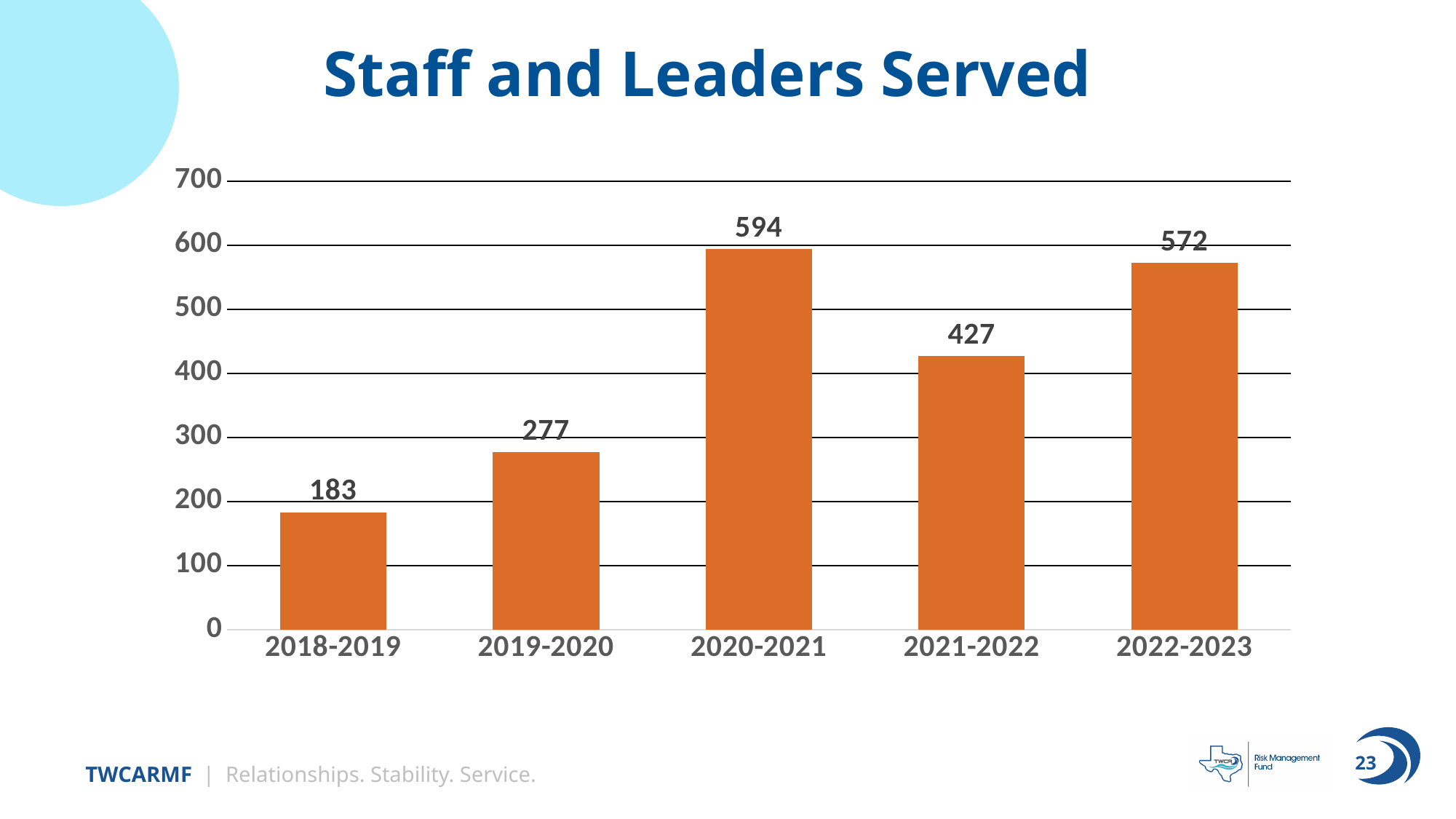
What is the value for 2022-2023? 572 What is the difference between the values for 2020-2021 and 2021-2022? 167 Is the value for 2021-2022 greater or less than 400? greater What is the value for 2020-2021? 594 What is the difference between the values for 2019-2020 and 2018-2019? 94 Which year has the highest value? 2020-2021 What kind of chart is shown on the slide? bar chart How many years are shown on the x axis? 5 Which year has the lowest value? 2018-2019 What is the title of the chart? Staff and Leaders Served Which is larger, the value for 2021-2022 or the value for 2022-2023? 2022-2023 What is the value for 2018-2019? 183